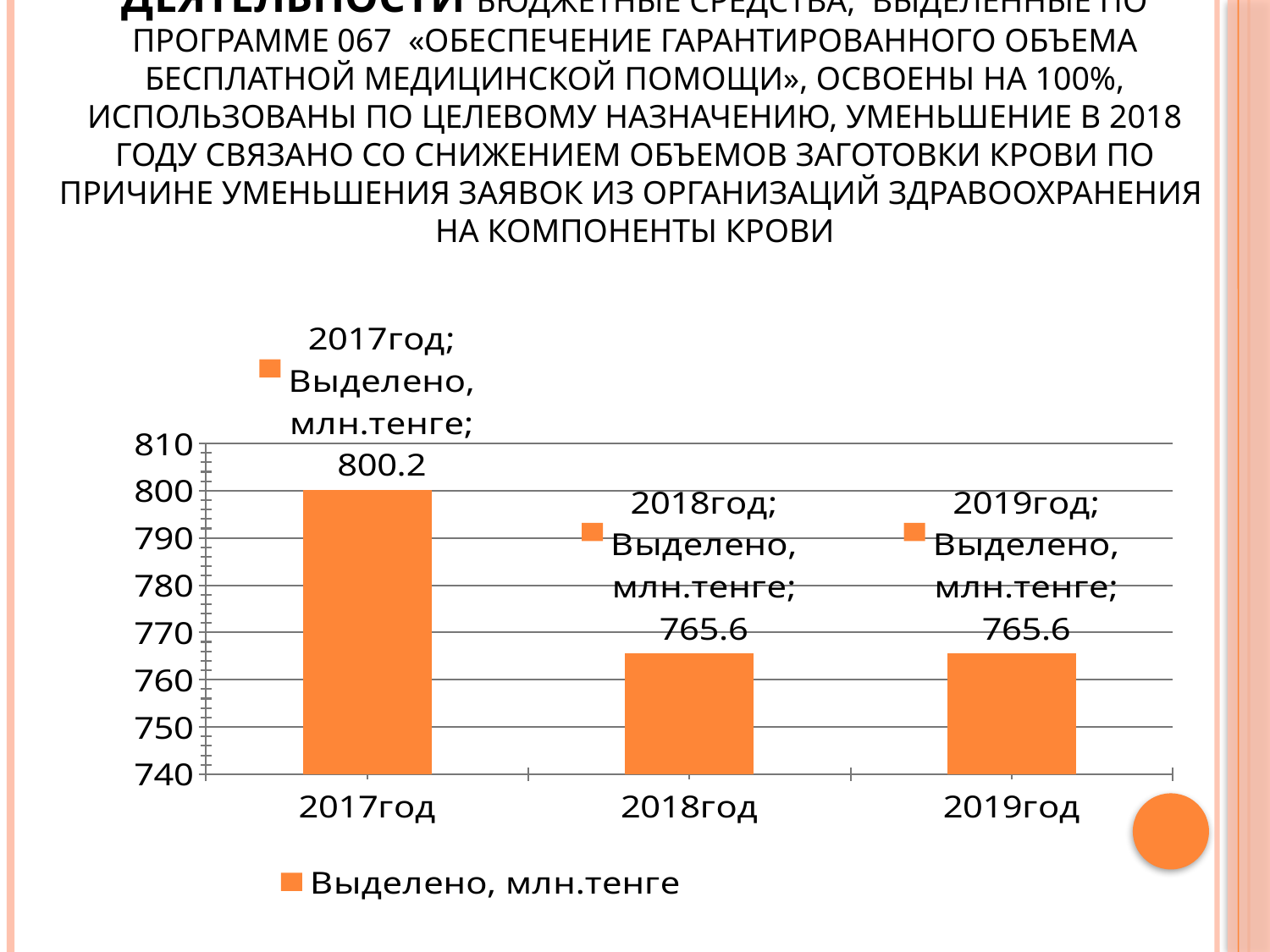
Which is larger, the value for 2017год or the value for 2019год? 2017год What is the value for 2019год? 765.6 What kind of chart is shown? bar chart How many years are shown on the x axis? 3 What is the name of the series in the legend? Выделено, млн.тенге Which year has the highest value? 2017год What is the value for 2017год? 800.2 What is the difference between the values for 2017год and 2018год? 34.6 Is the value for 2018год greater or less than 770? less What is the value for 2018год? 765.6 Is the value for 2017год greater or less than 790? greater How many series does the legend list? 1